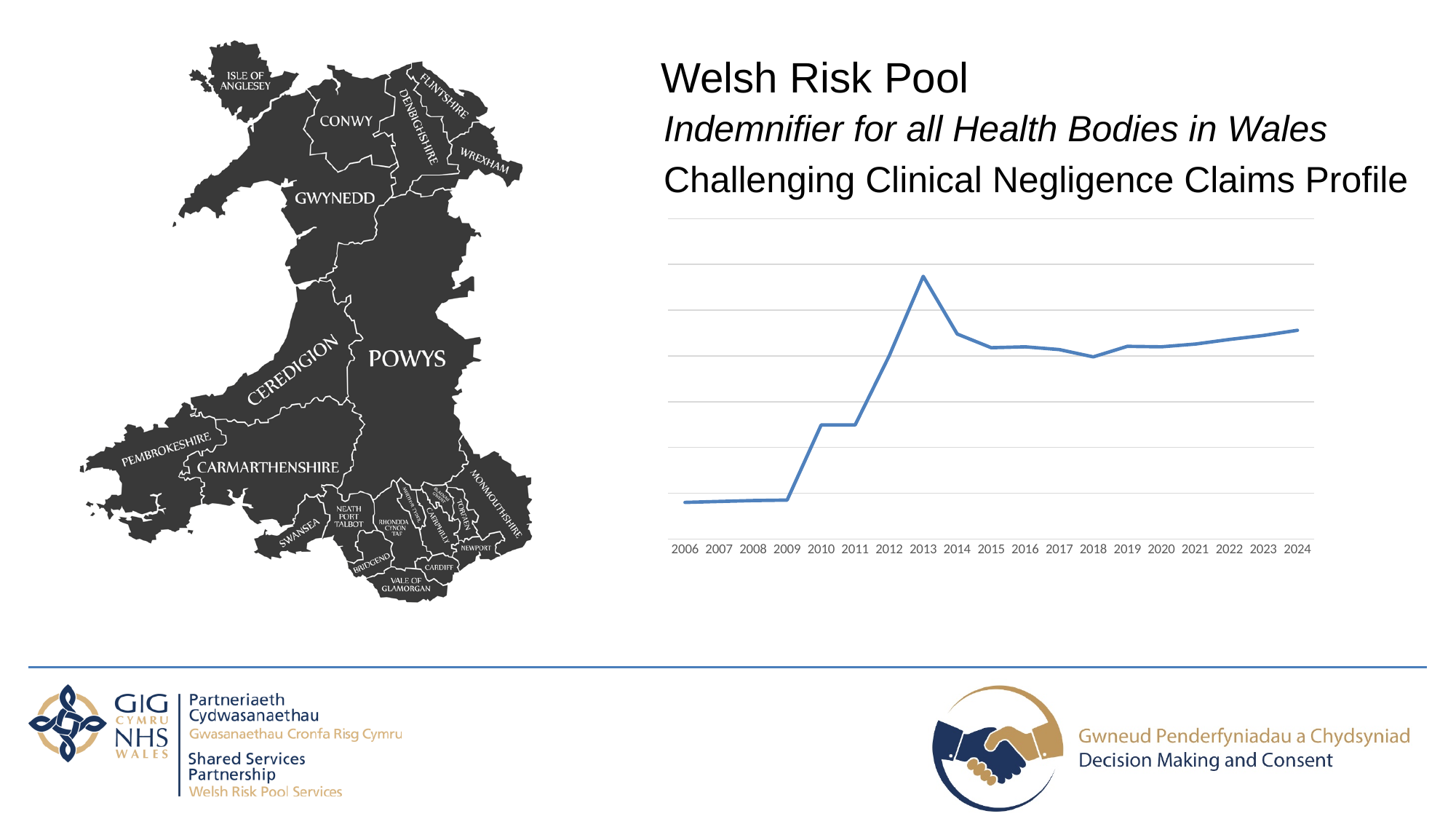
Does the line rise or fall between 2013 and 2014? fall Does the line rise or fall between 2009 and 2013? rise Which is larger, the value for 2013 or the value for 2024? 2013 Which is larger, the value for 2010 or the value for 2012? 2012 What kind of chart is shown on the slide? line chart Which is larger, the value for 2009 or the value for 2015? 2015 What is the last year shown on the x axis of the chart? 2024 What is the first year shown on the x axis of the chart? 2006 Which year has the highest value on the chart? 2013 Does the line rise or fall between 2018 and 2024? rise How many years are shown along the x axis of the chart? 19